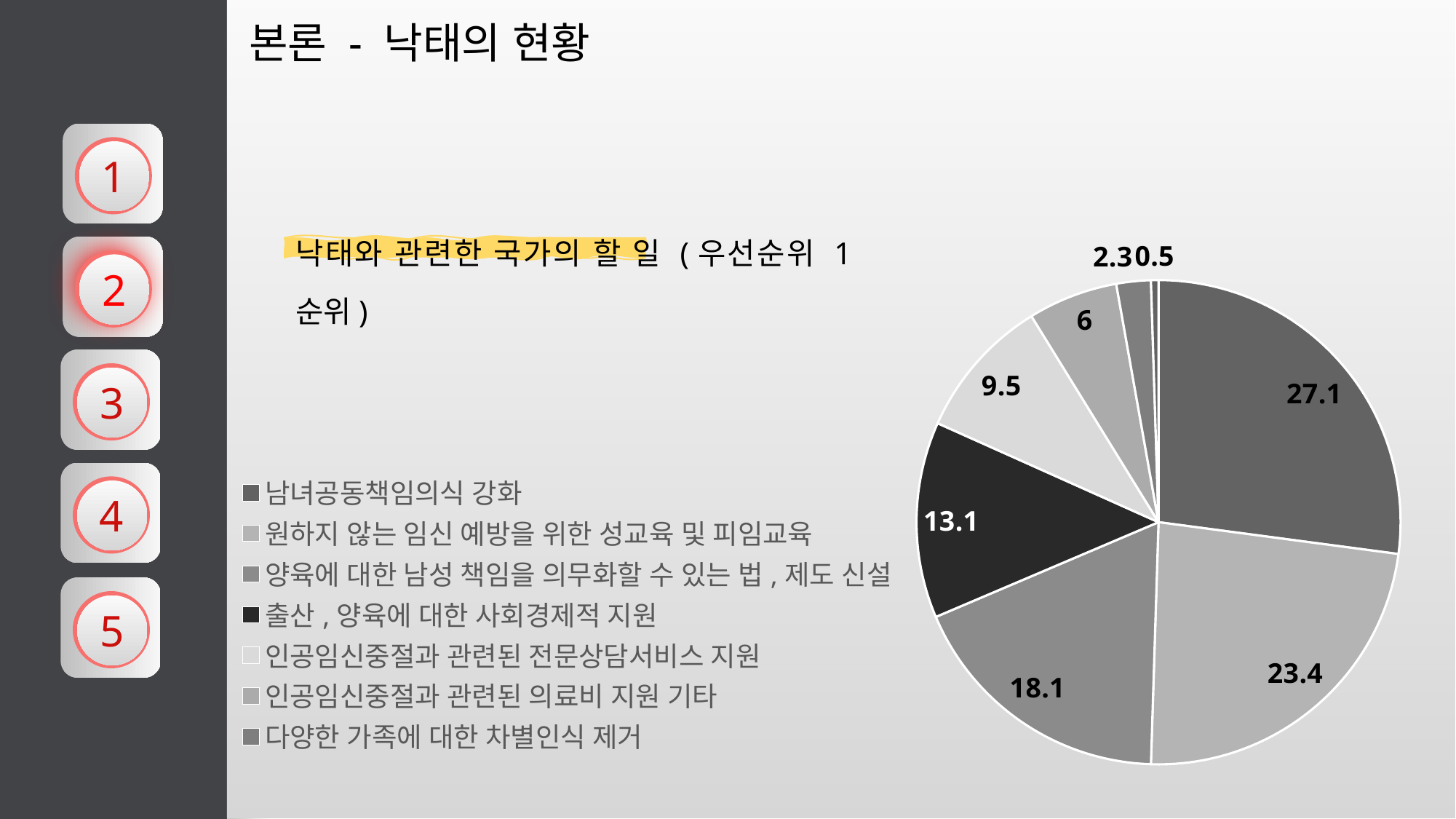
What is the value for 남녀공동책임의식 강화? 27.1 What is the value for 원하지 않는 임신 예방을 위한 성교육 및 피임교육? 23.4 What is the smallest value shown on the pie chart? 0.5 Which is larger: the slice labelled 18.1 or the slice labelled 13.1? 18.1 What is the difference between the two largest slices, 27.1 and 23.4? 3.7 What kind of chart is shown on the slide? pie chart Which legend entry is drawn in black on the pie chart? 출산, 양육에 대한 사회경제적 지원 What is the largest value shown on the pie chart? 27.1 What is the title of the pie chart? 낙태와 관련한 국가의 할 일 (우선순위 1순위) What is the difference between the slices labelled 9.5 and 6? 3.5 What is the value for 출산, 양육에 대한 사회경제적 지원? 13.1 How many entries does the legend of the pie chart list? 7